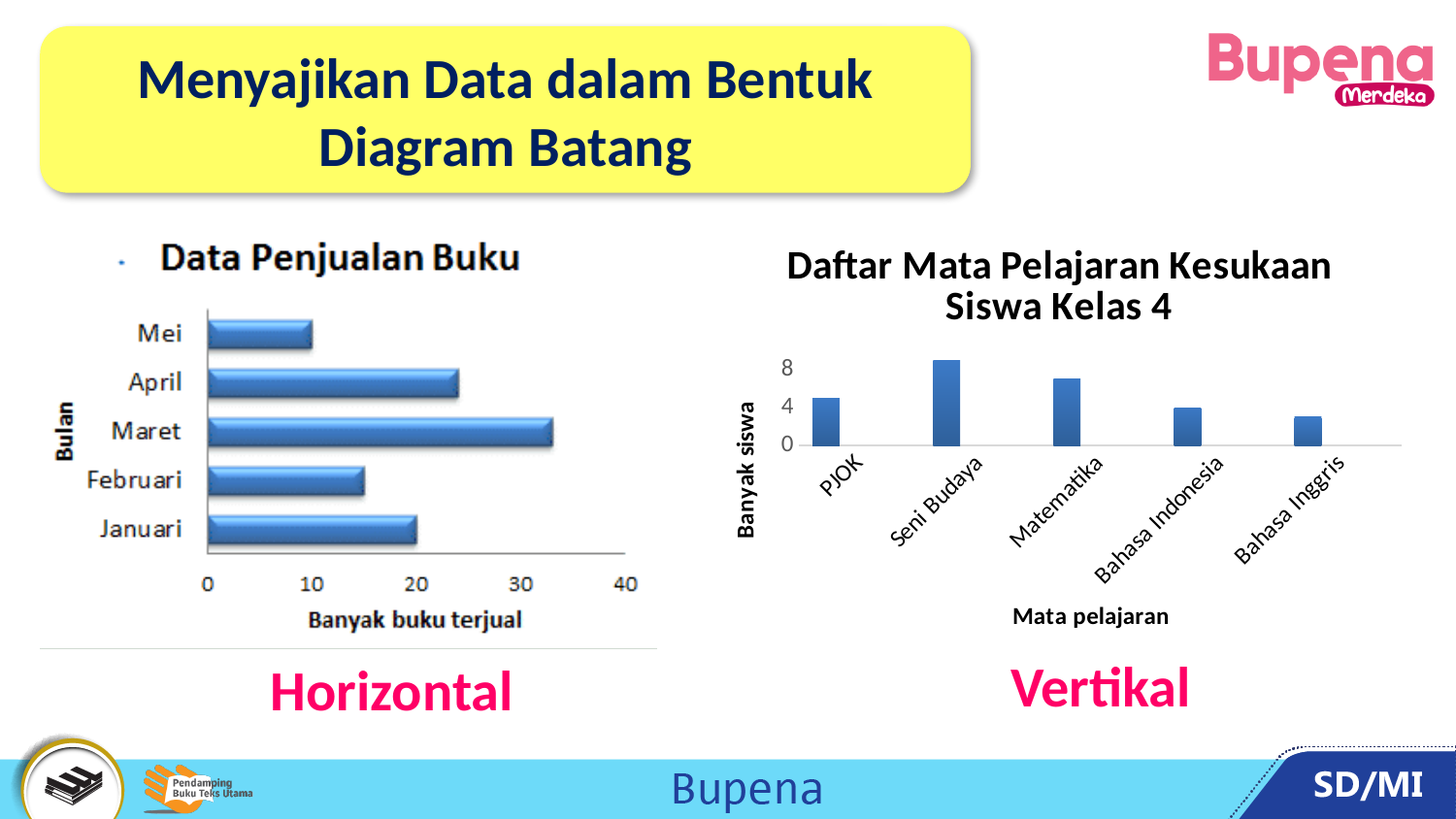
In the 'Daftar Mata Pelajaran Kesukaan Siswa Kelas 4' chart, which subject has the fewest students? Bahasa Inggris What type of chart is 'Data Penjualan Buku'? Bar chart In the 'Data Penjualan Buku' chart, what is the label of the horizontal axis? Banyak buku terjual In the 'Daftar Mata Pelajaran Kesukaan Siswa Kelas 4' chart, how many subjects are shown? 5 In the 'Data Penjualan Buku' chart, which month has the highest number of books sold? Maret In the 'Data Penjualan Buku' chart, how many months are shown? 5 In the 'Data Penjualan Buku' chart, is the value for Maret greater or less than 30? greater In the 'Data Penjualan Buku' chart, which month has the lowest number of books sold? Mei In the 'Daftar Mata Pelajaran Kesukaan Siswa Kelas 4' chart, is the value for Seni Budaya greater or less than 8? greater In the 'Data Penjualan Buku' chart, which is larger, the value for April or the value for Januari? April In the 'Data Penjualan Buku' chart, is the value for Februari greater or less than 20? less In the 'Daftar Mata Pelajaran Kesukaan Siswa Kelas 4' chart, which subject has the most students? Seni Budaya